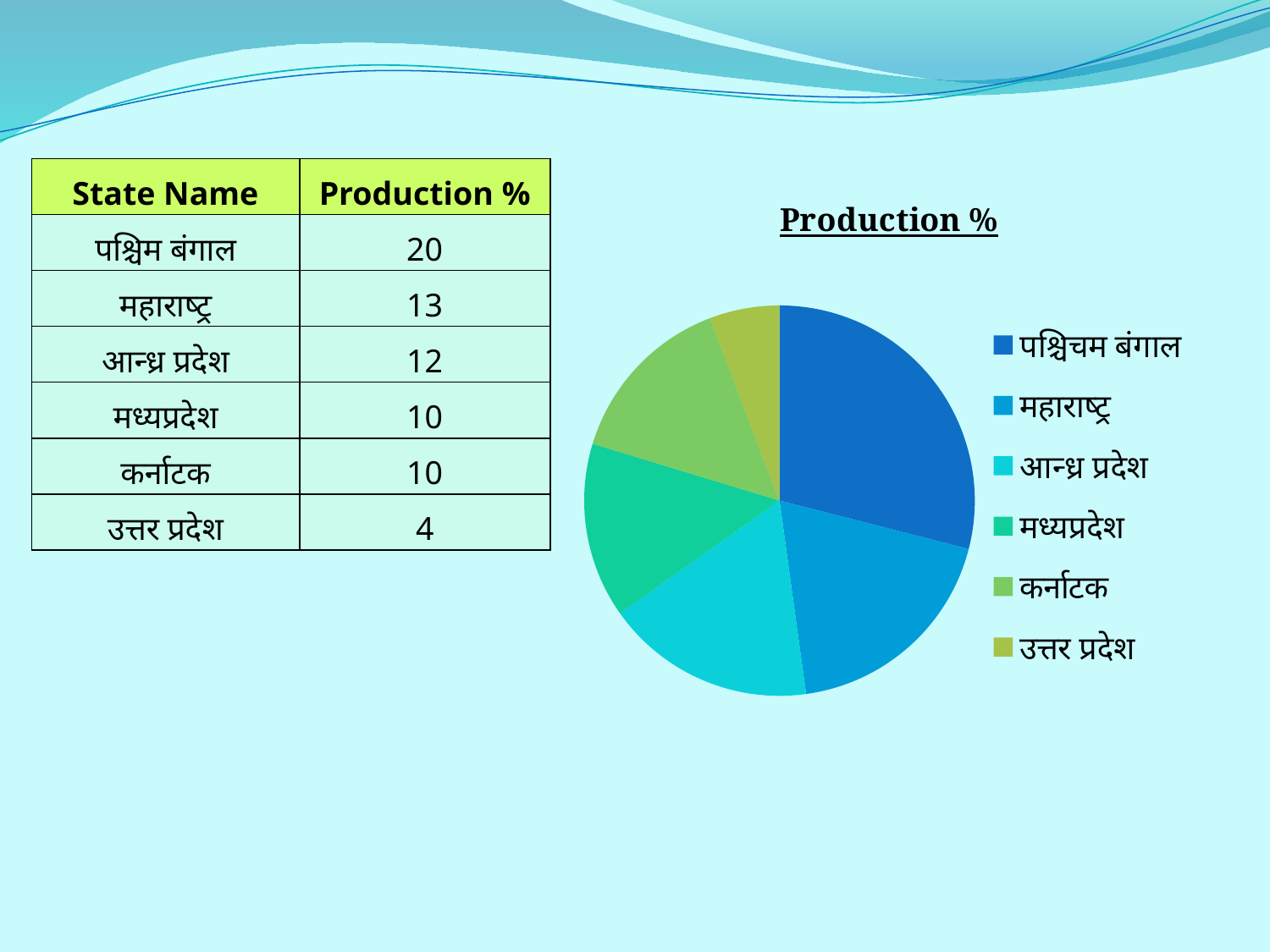
What colour is the slice for पश्चिम बंगाल in the pie chart? dark blue Which state has the smallest slice in the pie chart? उत्तर प्रदेश How many entries does the pie chart's legend list? 6 According to the table, what is the Production % for उत्तर प्रदेश? 4 Which state has the largest slice in the pie chart? पश्चिम बंगाल Which has a higher Production %, आन्ध्र प्रदेश or उत्तर प्रदेश? आन्ध्र प्रदेश What kind of chart is shown on the slide? pie chart How many slices does the pie chart have? 6 According to the table, what is the Production % for महाराष्ट्र? 13 What is the title of the pie chart? Production % According to the table, what is the Production % for पश्चिम बंगाल? 20 What is the difference in Production % between पश्चिम बंगाल and महाराष्ट्र? 7